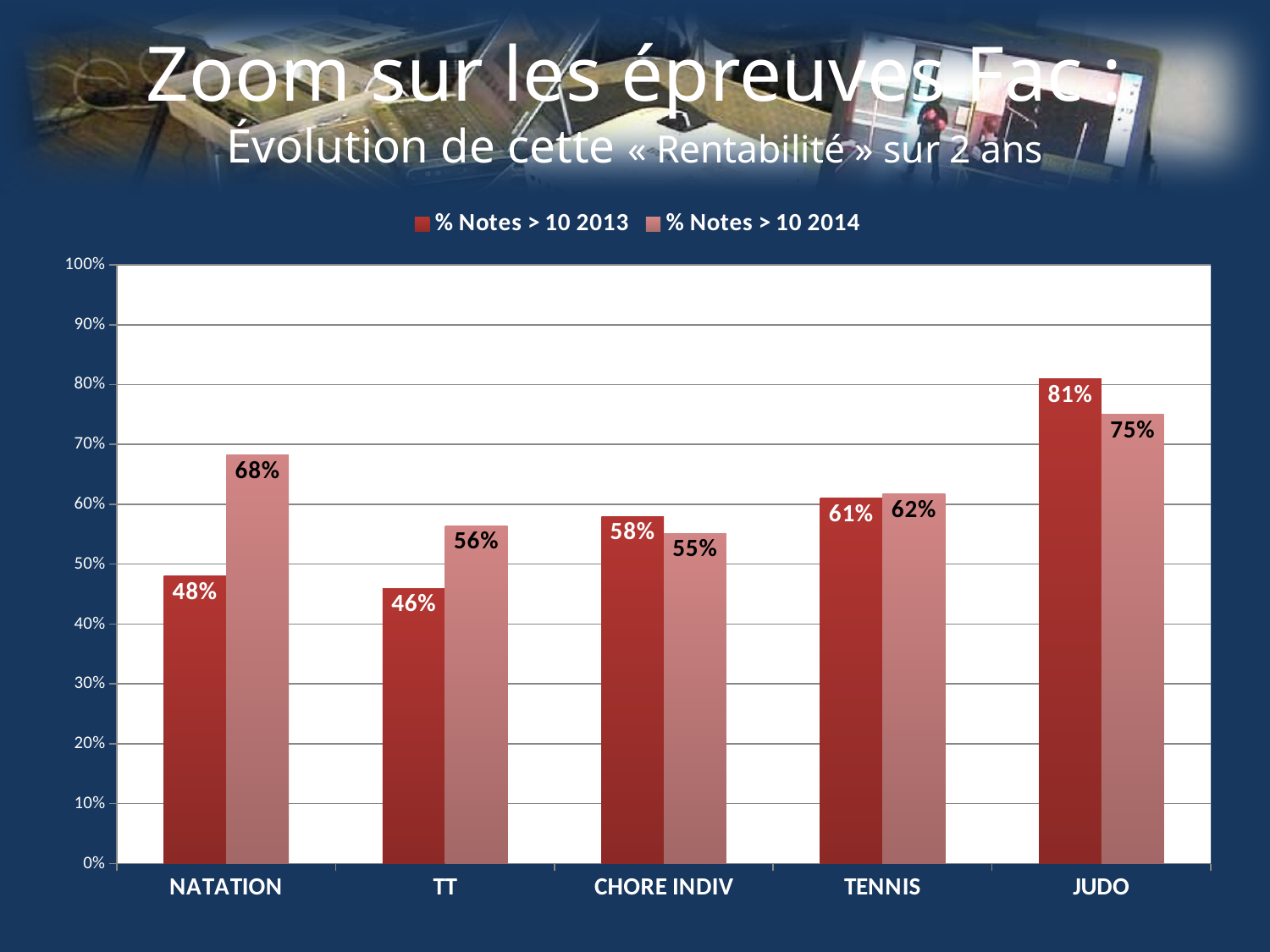
What is the value for NATATION in the % Notes > 10 2014 series? 68% Is the value for TENNIS in the % Notes > 10 2014 series greater or less than 50%? greater What kind of chart is shown on the slide? Bar chart What is the difference between the 2014 and 2013 values for NATATION? 20% How many series does the legend list? 2 What is the value for TT in the % Notes > 10 2013 series? 46% How many categories are shown on the x axis? 5 Which category has the highest value in the % Notes > 10 2014 series? JUDO Which is larger for CHORE INDIV: the % Notes > 10 2013 value or the % Notes > 10 2014 value? % Notes > 10 2013 Which category has the lowest value in the % Notes > 10 2013 series? TT What is the value for JUDO in the % Notes > 10 2013 series? 81% What is the difference between the 2013 and 2014 values for JUDO? 6%